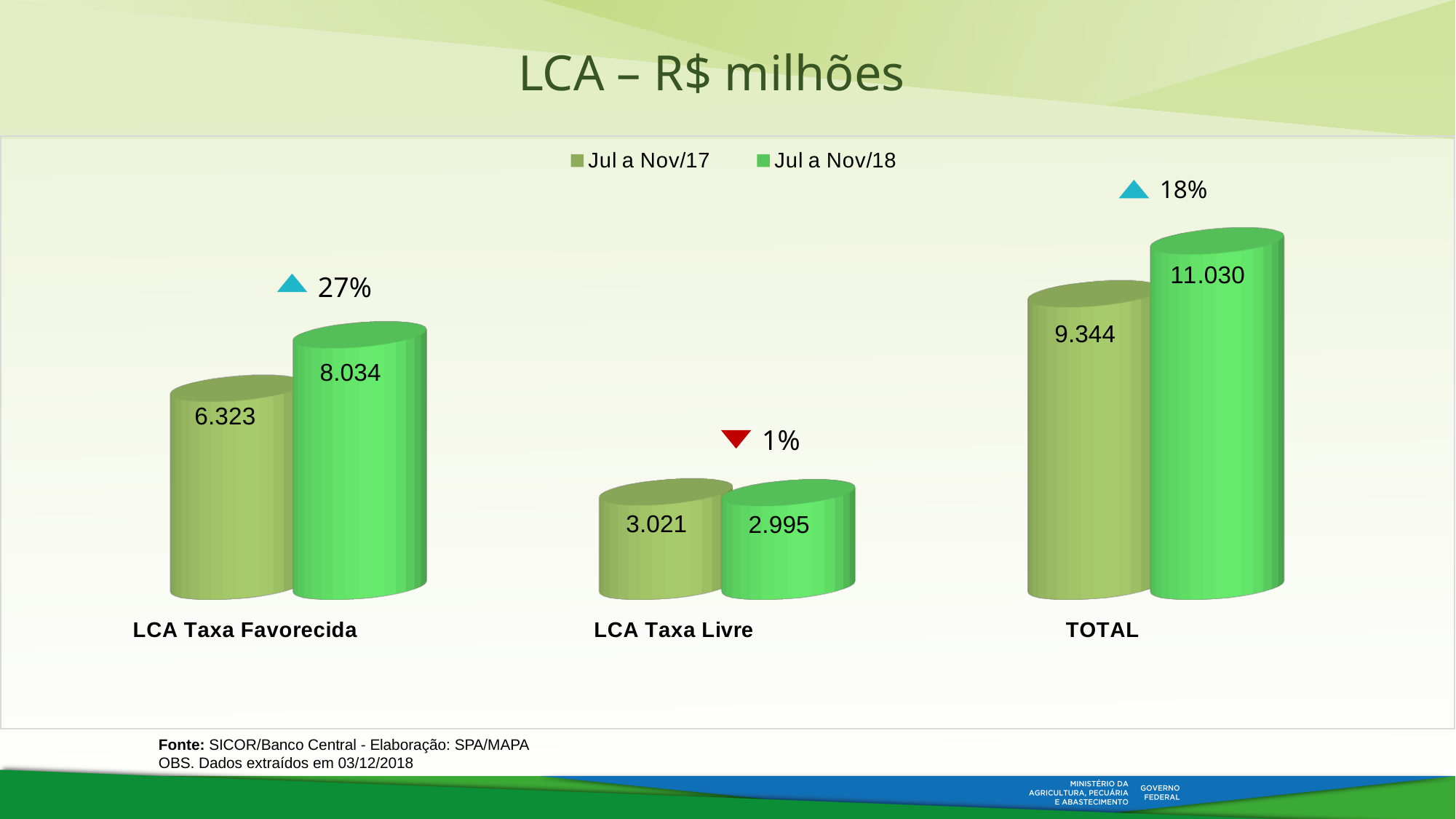
What is the difference between the Jul a Nov/18 and Jul a Nov/17 values for LCA Taxa Favorecida? 1.711 What is the difference between the Jul a Nov/18 and Jul a Nov/17 values for TOTAL? 1.686 How many categories are shown on the x axis? 3 Which category has the lowest value in Jul a Nov/17? LCA Taxa Livre How many series does the legend list? 2 What is the value for TOTAL in Jul a Nov/17? 9.344 What is the value for LCA Taxa Favorecida in Jul a Nov/18? 8.034 Which category has the highest value in Jul a Nov/18? TOTAL For LCA Taxa Livre, which is larger: the Jul a Nov/17 value or the Jul a Nov/18 value? Jul a Nov/17 What is the value for LCA Taxa Livre in Jul a Nov/18? 2.995 What kind of chart is shown on the slide? Bar chart What percentage change is shown above the TOTAL bars? 18%